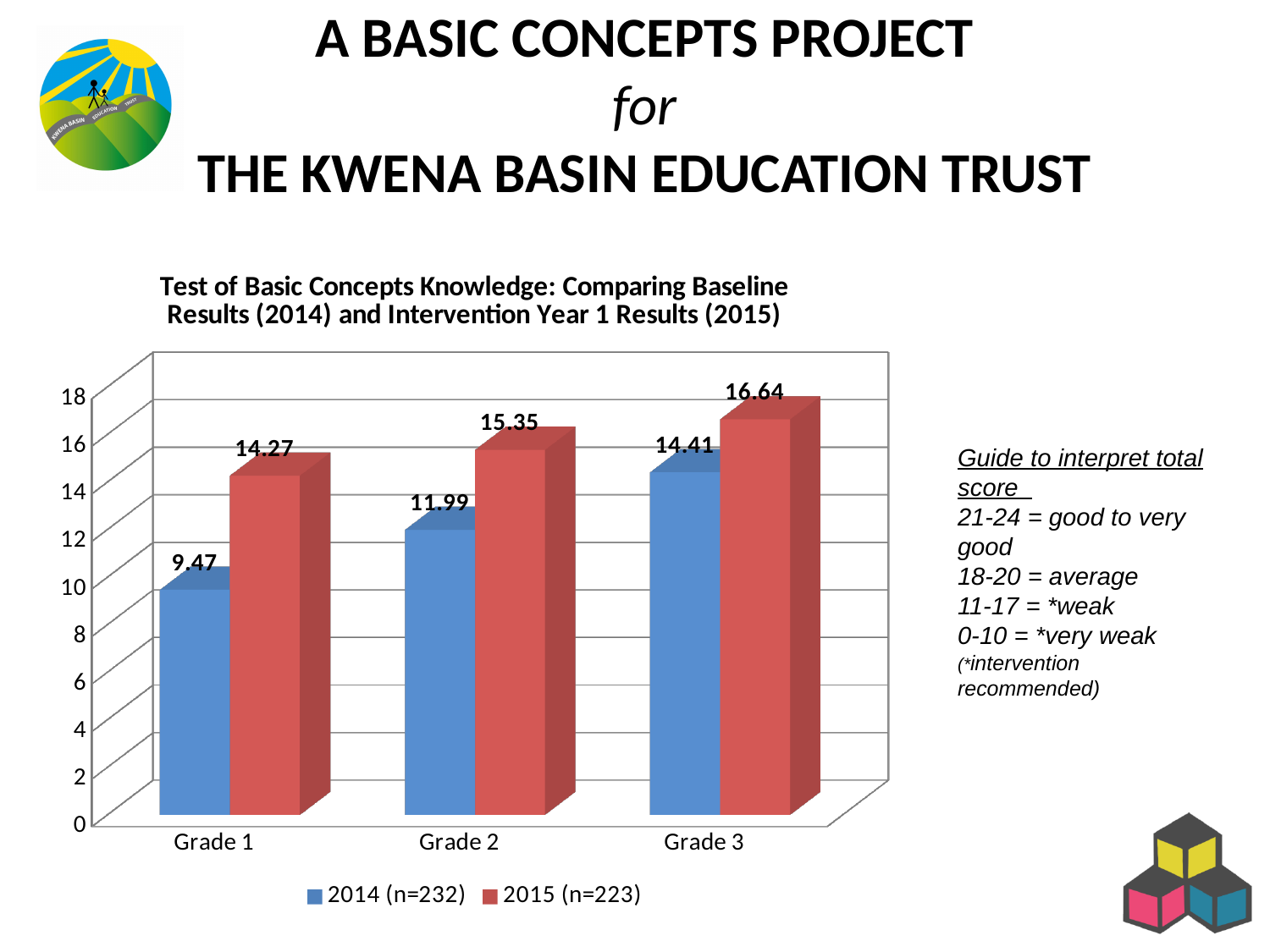
Which grade has the highest 2015 (n=223) value? Grade 3 What is the 2015 (n=223) value for Grade 3? 16.64 What is the difference between the 2015 (n=223) and 2014 (n=232) values for Grade 1? 4.80 Do the 2014 (n=232) values rise or fall from Grade 1 to Grade 3? Rise Which grade has the lowest 2014 (n=232) value? Grade 1 What is the difference between the 2015 (n=223) and 2014 (n=232) values for Grade 3? 2.23 How many grade categories are shown on the x axis? 3 What kind of chart is shown on the slide? Bar chart How many series does the legend list? 2 What is the 2014 (n=232) value for Grade 1? 9.47 Which is larger for Grade 2: the 2014 (n=232) value or the 2015 (n=223) value? 2015 (n=223) What is the 2014 (n=232) value for Grade 2? 11.99